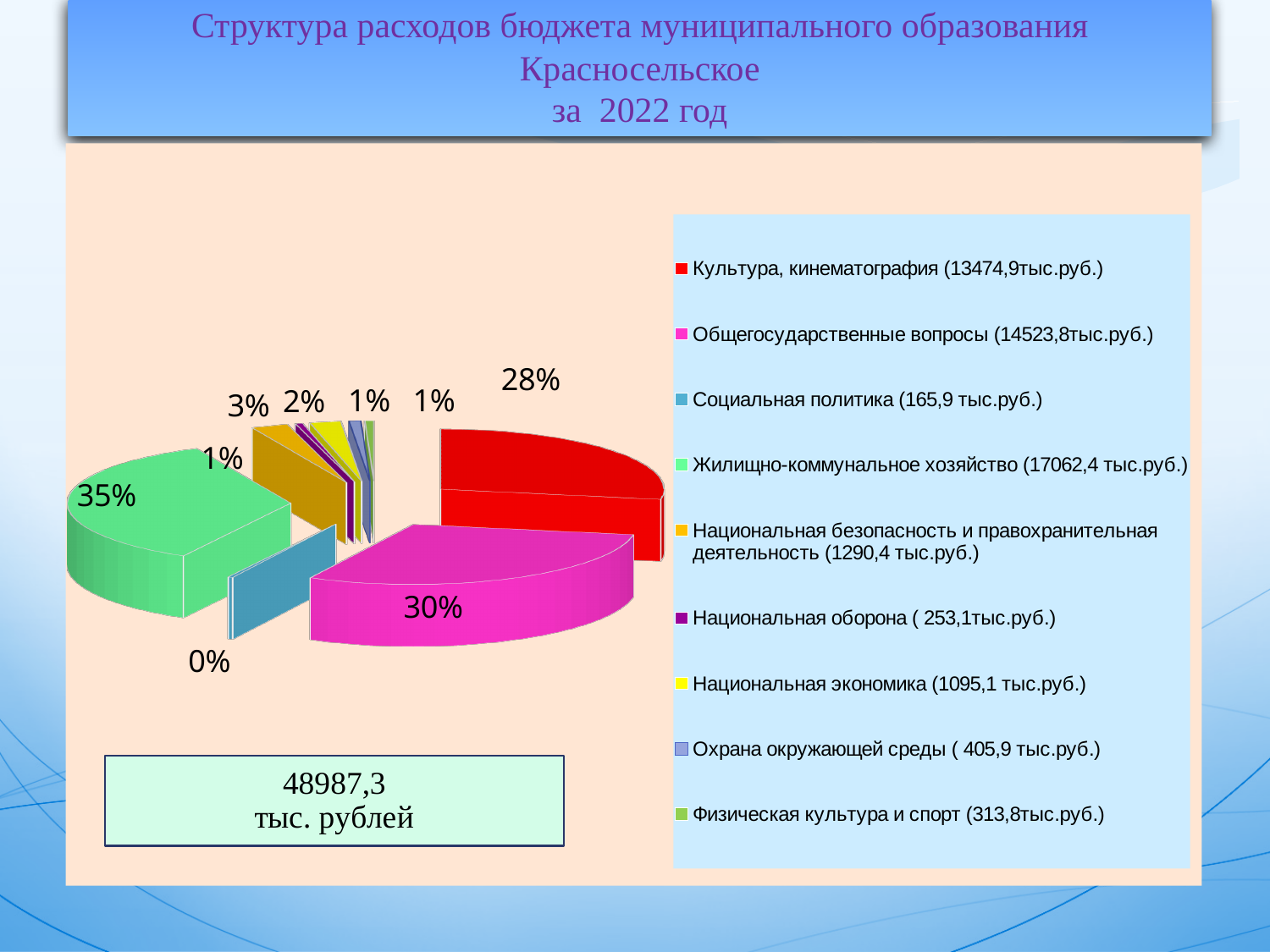
What amount is shown in the legend for Охрана окружающей среды? 405,9 тыс.руб. Which category has the largest share of the pie? Жилищно-коммунальное хозяйство What kind of chart is shown on the slide? pie chart What total amount is shown in the box below the pie chart? 48987,3 тыс. рублей How many categories does the legend of the pie chart list? 9 What is the difference between the amounts for Жилищно-коммунальное хозяйство (17062,4) and Общегосударственные вопросы (14523,8)? 2538,6 тыс.руб. Which is larger: the amount for Общегосударственные вопросы or for Культура, кинематография? Общегосударственные вопросы What share of the pie does Общегосударственные вопросы take? 30% What share of the pie does Культура, кинематография take? 28% What amount is shown in the legend for Национальная оборона? 253,1тыс.руб. What amount is shown in the legend for Культура, кинематография? 13474,9тыс.руб. What share of the pie does Жилищно-коммунальное хозяйство take? 35%